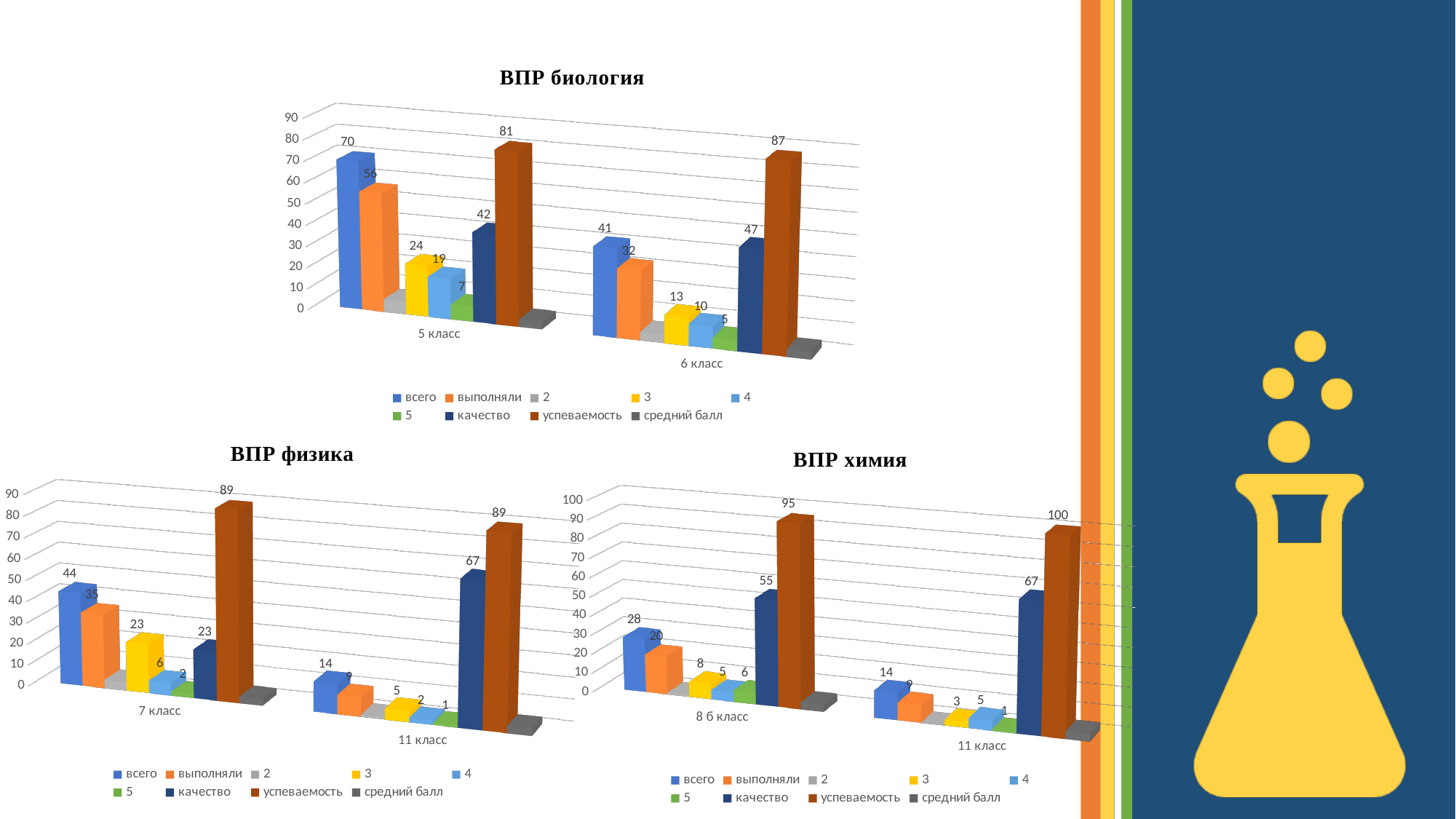
In the ВПР физика chart, is the value of успеваемость for 7 класс greater or less than 80? greater In the ВПР биология chart, which class has the higher качество value? 6 класс In the ВПР физика chart, what is the value of качество for 11 класс? 67 In the ВПР биология chart, what is the value of успеваемость for 6 класс? 87 In the ВПР биология chart, what is the value of всего for 5 класс? 70 How many class categories are shown on the x axis of the ВПР химия chart? 2 How many series does the legend of the ВПР физика chart list? 9 What type of chart is the ВПР химия chart? Bar chart In the ВПР химия chart, what is the value of успеваемость for 11 класс? 100 In the ВПР биология chart, what is the difference between выполняли for 5 класс and выполняли for 6 класс? 24 In the ВПР химия chart, what is the difference between качество for 11 класс and качество for 8 б класс? 12 In the ВПР физика chart, what is the value of всего for 7 класс? 44